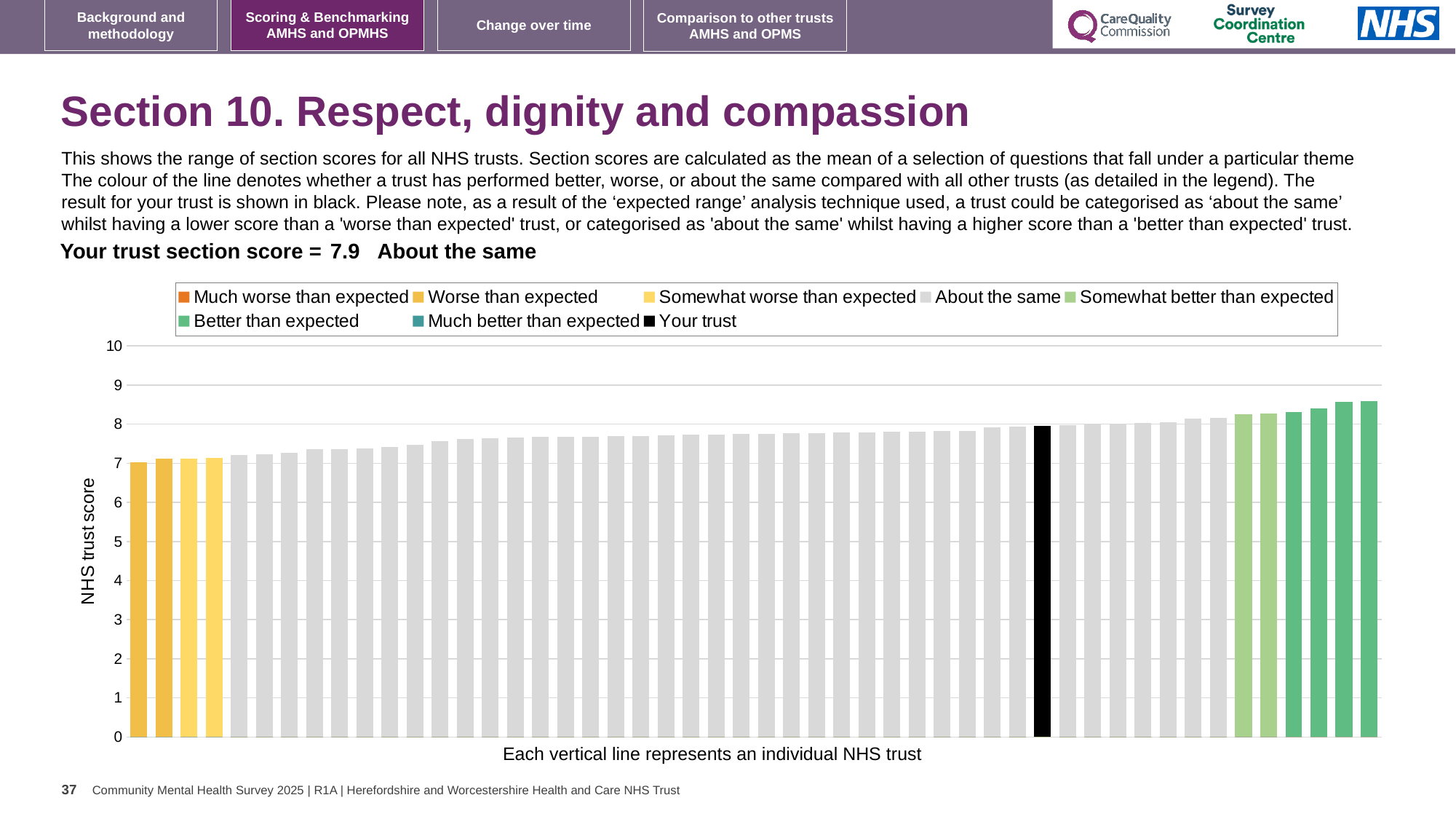
Which is higher, the black bar for your trust or the rightmost bar? the rightmost bar What kind of chart is shown on the slide? bar chart How many bars are shown in the 'Much worse than expected' colour? 0 Which category is your trust's section score placed in? About the same What is the section score for your trust shown on the slide? 7.9 Is the value of the leftmost bar greater or less than 8? less Is the value of the black bar (your trust) greater or less than 7? greater How many entries does the chart legend list? 8 What is the label on the vertical axis of the chart? NHS trust score Is the value of the rightmost bar greater or less than 8? greater What colour is used for 'Your trust' in the chart legend? black Do the bar values rise or fall from left to right across the chart? rise